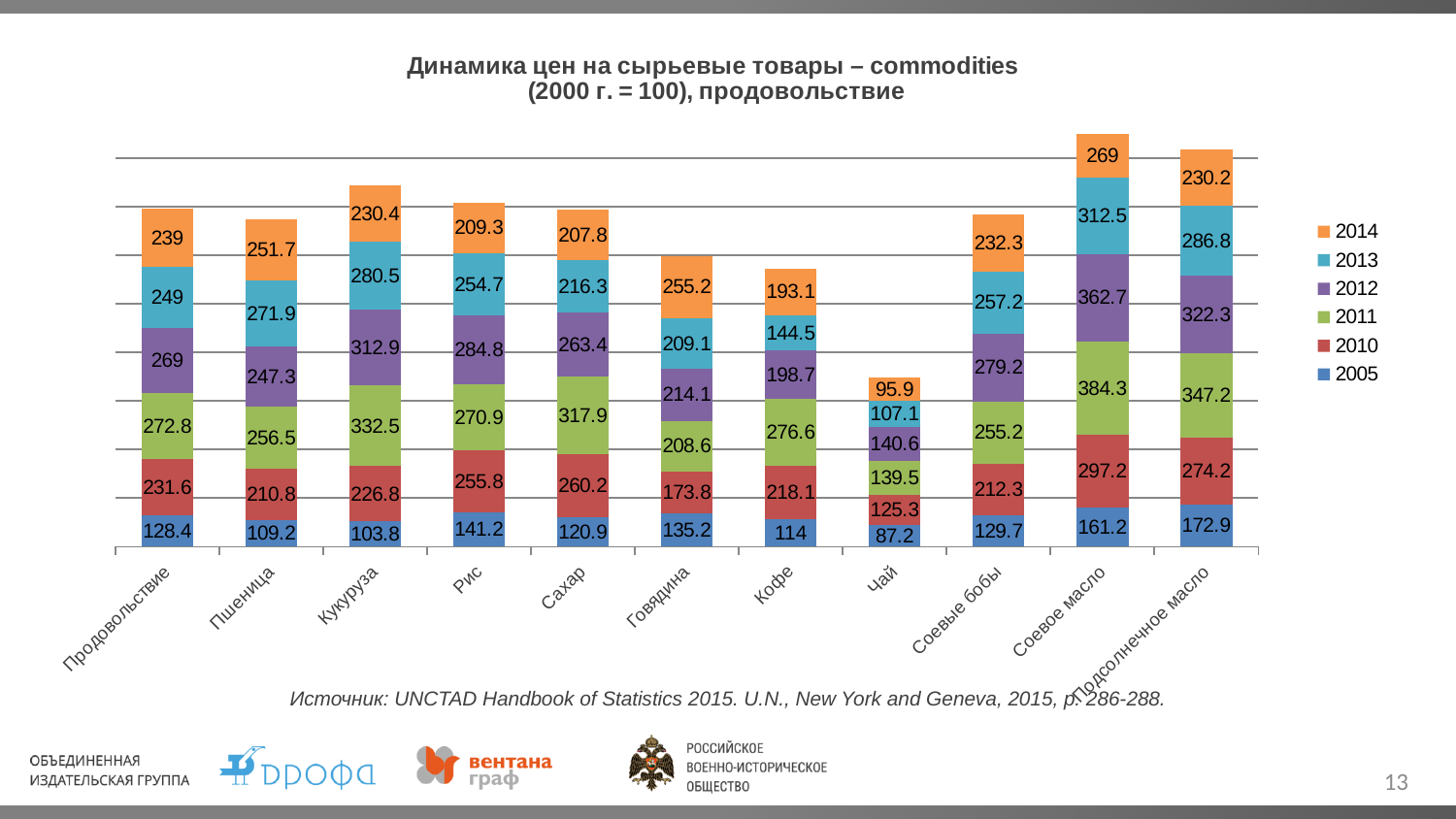
What is the value for Пшеница in the 2013 series? 271.9 Which category has the highest value in the 2005 series? Подсолнечное масло Which category has the lowest value in the 2011 series? Чай What is the difference between the 2014 values for Соевое масло and Чай? 173.1 What kind of chart is shown on the slide? Stacked bar chart What is the value for Чай in the 2005 series? 87.2 How many series does the legend list? 6 What is the total of the stacked bar for Чай? 695.6 What is the value for Соевое масло in the 2011 series? 384.3 Which is larger in the 2005 series: Рис or Сахар? Рис What is the value for Кофе in the 2014 series? 193.1 How many categories are shown on the x axis? 11